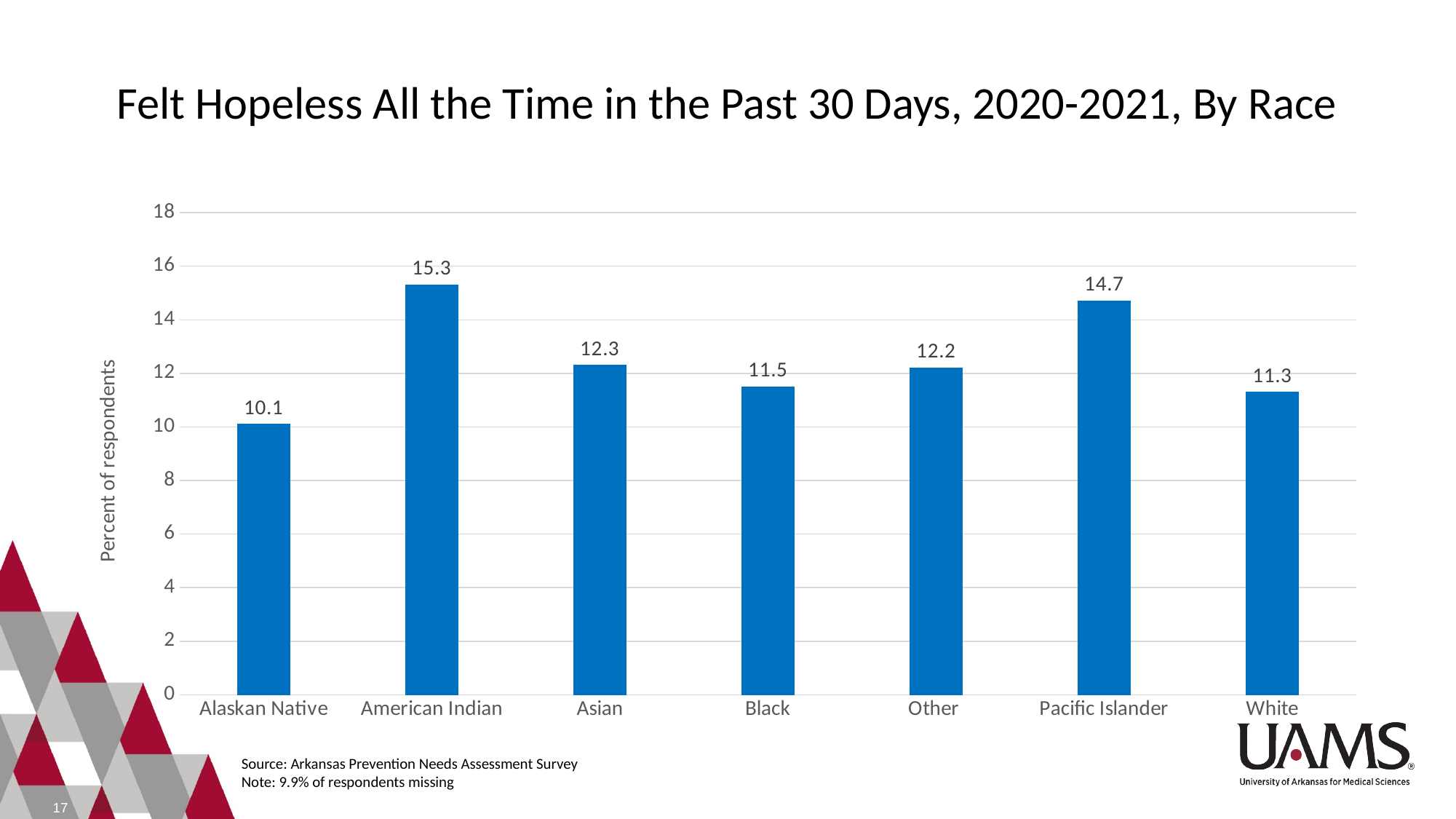
How many race categories are shown on the chart? 7 Which race category has the highest value? American Indian What is the label of the vertical axis? Percent of respondents Which is larger, the value for Asian or the value for Black? Asian What is the difference between the values for Pacific Islander and White? 3.4 What is the value for White respondents? 11.3 Is the value for Pacific Islander greater or less than 14? greater Which race category has the lowest value? Alaskan Native What is the value for Black respondents? 11.5 What is the difference between the values for American Indian and Alaskan Native? 5.2 What kind of chart is shown on the slide? Bar chart What is the value for American Indian respondents? 15.3